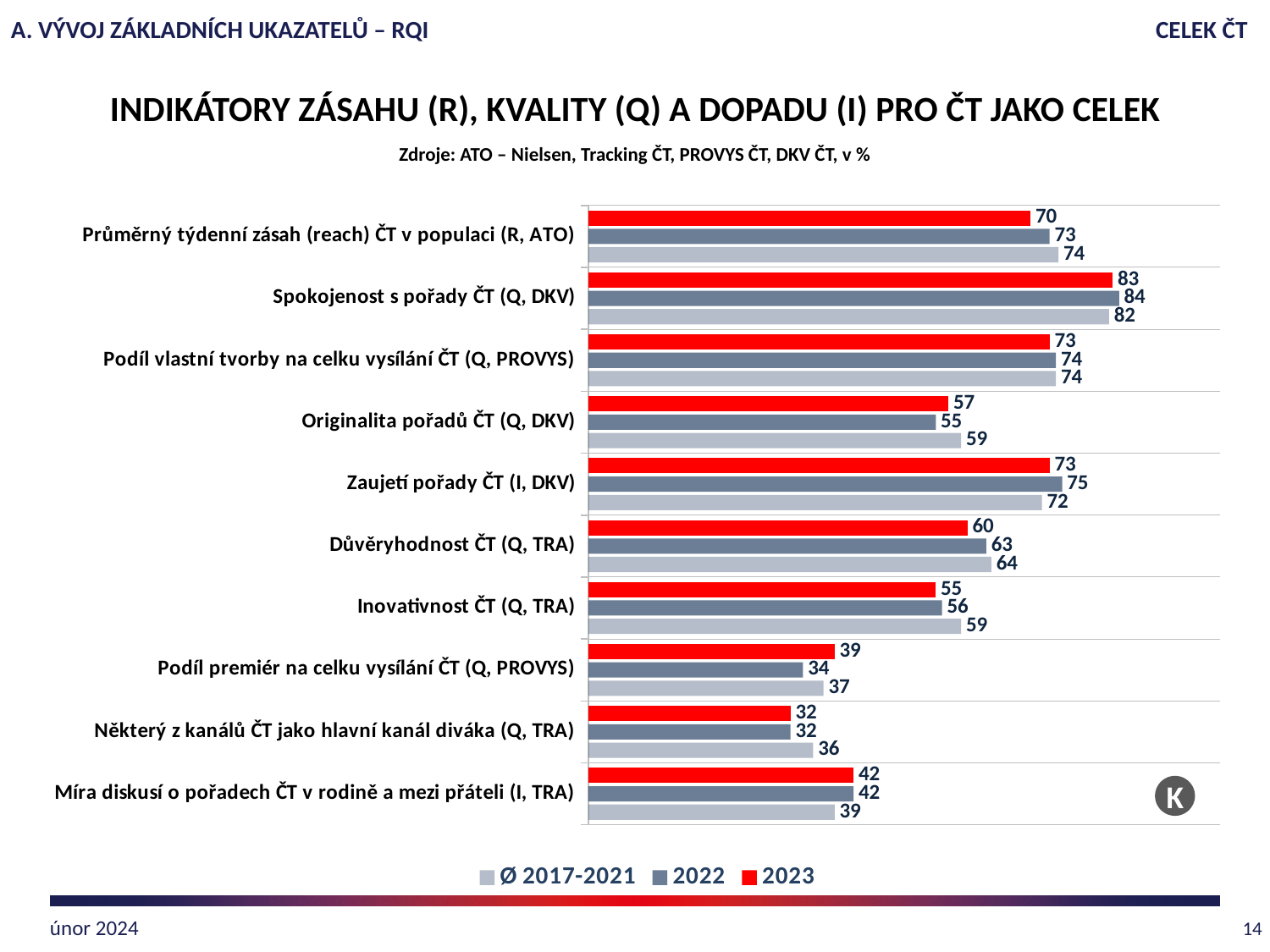
For Průměrný týdenní zásah (reach) ČT v populaci (R, ATO), which is larger: the 2023 value or the Ø 2017-2021 value? Ø 2017-2021 How many series does the legend list? 3 Which colour represents the 2023 series in the chart? Red What is the difference between the 2023 and 2022 values for Podíl premiér na celku vysílání ČT (Q, PROVYS)? 5 What is the Ø 2017-2021 value for Originalita pořadů ČT (Q, DKV)? 59 What is the 2022 value for Důvěryhodnost ČT (Q, TRA)? 63 Which category has the lowest 2023 value? Některý z kanálů ČT jako hlavní kanál diváka (Q, TRA) How many categories are shown in the chart? 10 Which category has the highest 2023 value? Spokojenost s pořady ČT (Q, DKV) What is the 2023 value for Spokojenost s pořady ČT (Q, DKV)? 83 What is the 2023 value for Míra diskusí o pořadech ČT v rodině a mezi přáteli (I, TRA)? 42 What kind of chart is shown on the slide? Bar chart